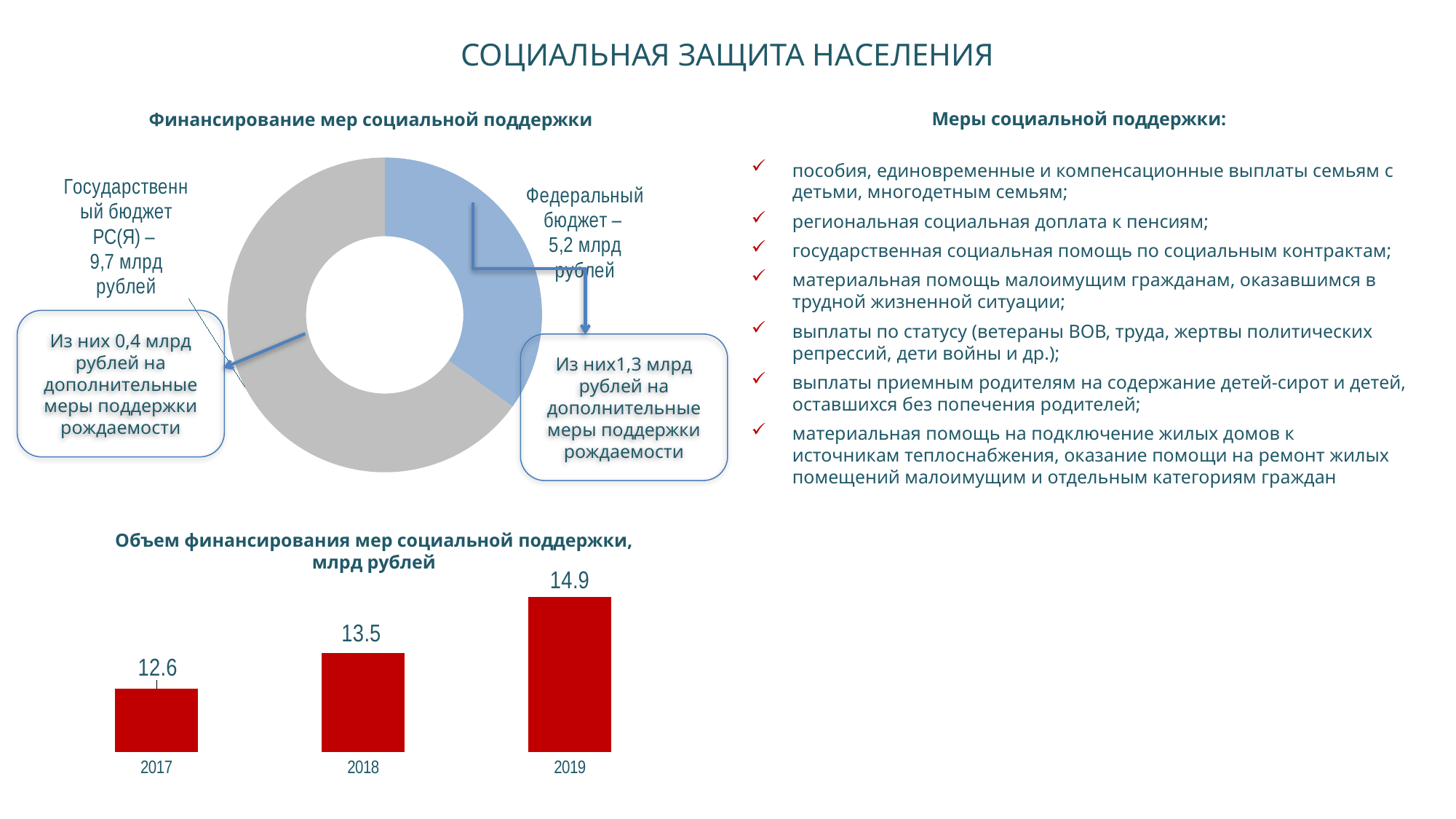
What kind of chart is 'Объем финансирования мер социальной поддержки, млрд рублей'? bar chart How many bars are in the bar chart 'Объем финансирования мер социальной поддержки, млрд рублей'? 3 In the donut chart 'Финансирование мер социальной поддержки', which is larger: Государственный бюджет РС(Я) or Федеральный бюджет? Государственный бюджет РС(Я) In the bar chart 'Объем финансирования мер социальной поддержки, млрд рублей', do the values rise or fall from 2017 to 2019? rise In the bar chart 'Объем финансирования мер социальной поддержки, млрд рублей', what is the value for 2018? 13.5 In the donut chart 'Финансирование мер социальной поддержки', what is the value for Федеральный бюджет? 5,2 млрд рублей In the bar chart 'Объем финансирования мер социальной поддержки, млрд рублей', which year has the highest value? 2019 In the bar chart 'Объем финансирования мер социальной поддержки, млрд рублей', which year has the lowest value? 2017 In the bar chart 'Объем финансирования мер социальной поддержки, млрд рублей', what is the value for 2019? 14.9 In the bar chart 'Объем финансирования мер социальной поддержки, млрд рублей', what is the value for 2017? 12.6 In the donut chart 'Финансирование мер социальной поддержки', what is the value for Государственный бюджет РС(Я)? 9,7 млрд рублей In the bar chart 'Объем финансирования мер социальной поддержки, млрд рублей', what is the difference between the 2019 and 2017 values? 2.3